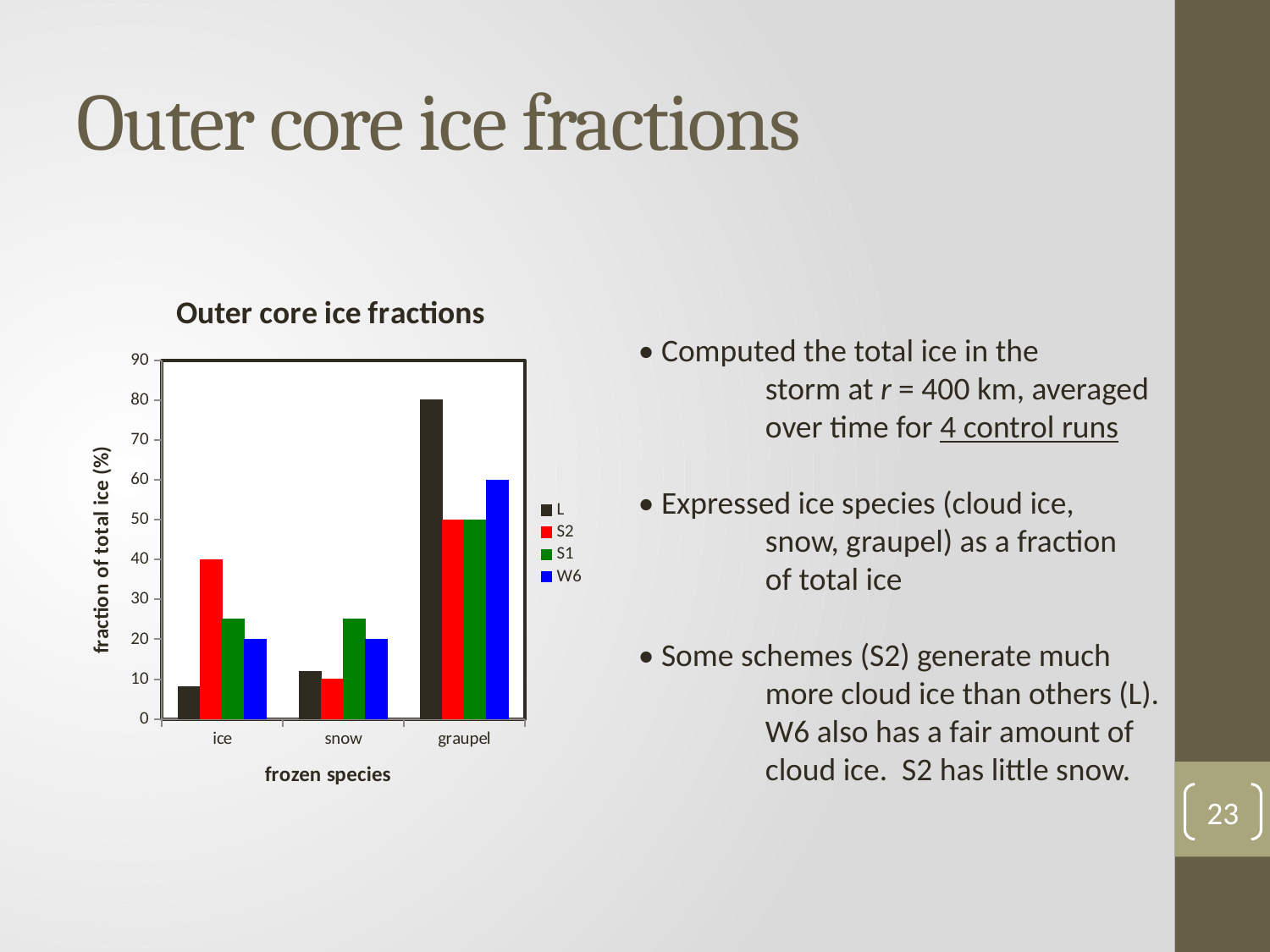
How many categories are shown on the x axis of the chart? 3 Which series has the lowest value for ice? L Is the value for L in the graupel category greater or less than 70? greater Which series has the highest value for ice? S2 Is the value for S2 in the snow category greater or less than 20? less What is the label of the y axis of the chart? fraction of total ice (%) How many series does the legend of the chart list? 4 Which series has the highest value for graupel? L What is the title of the chart? Outer core ice fractions Is the value for S2 in the ice category greater or less than 30? greater What kind of chart is shown on the slide? bar chart For the snow category, which is larger, the value for S1 or the value for S2? S1